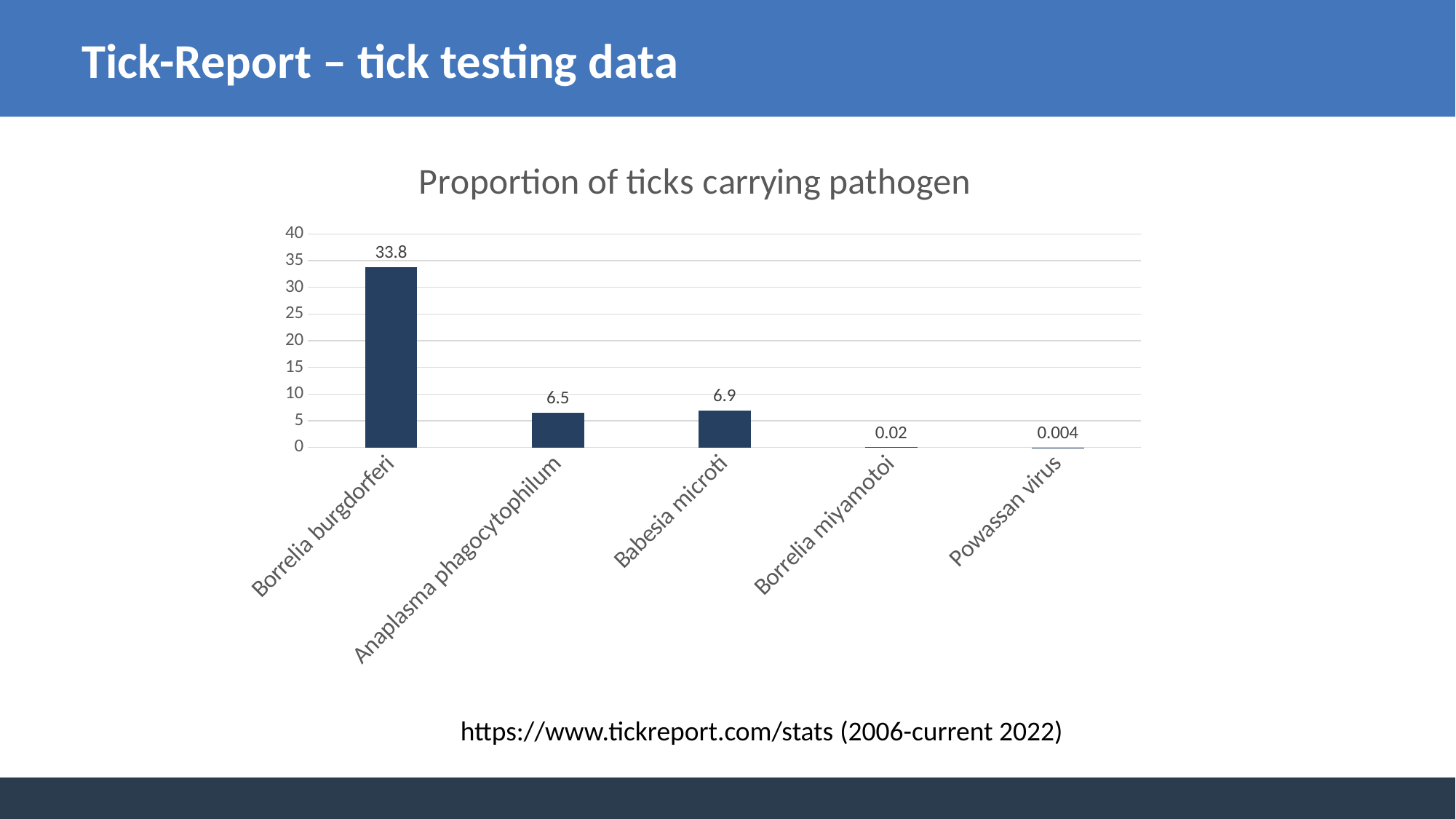
How many pathogens are shown in the chart? 5 What kind of chart is shown on the slide? Bar chart Is the value for Borrelia burgdorferi greater or less than 30? greater What is the value for Borrelia burgdorferi? 33.8 What is the value for Powassan virus? 0.004 What is the value for Borrelia miyamotoi? 0.02 What is the value for Babesia microti? 6.9 Which pathogen has the lowest proportion? Powassan virus What is the difference between the values for Borrelia burgdorferi and Babesia microti? 26.9 Which pathogen has the highest proportion? Borrelia burgdorferi Which is larger, the value for Babesia microti or Anaplasma phagocytophilum? Babesia microti What is the value for Anaplasma phagocytophilum? 6.5